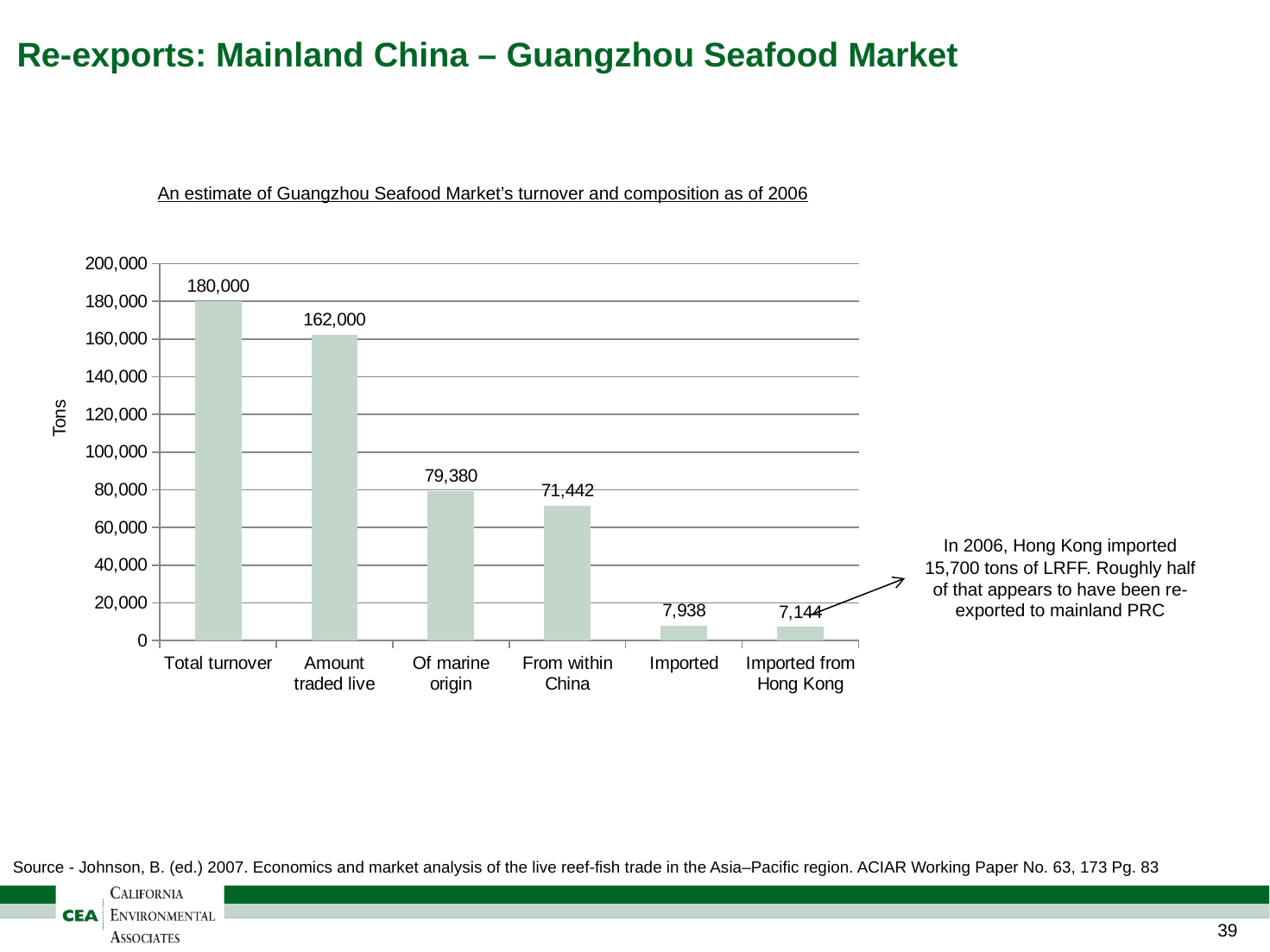
What is the difference between Of marine origin and From within China? 7,938 What kind of chart is shown on the slide? Bar chart What is the label on the y axis? Tons What is the difference between Total turnover and Amount traded live? 18,000 Which is larger, Imported or Imported from Hong Kong? Imported Which category has the highest value? Total turnover What is the value for Total turnover? 180,000 How many categories are shown on the x axis? 6 What is the value for Imported from Hong Kong? 7,144 What is the value for Of marine origin? 79,380 Which category has the lowest value? Imported from Hong Kong What is the value for Amount traded live? 162,000